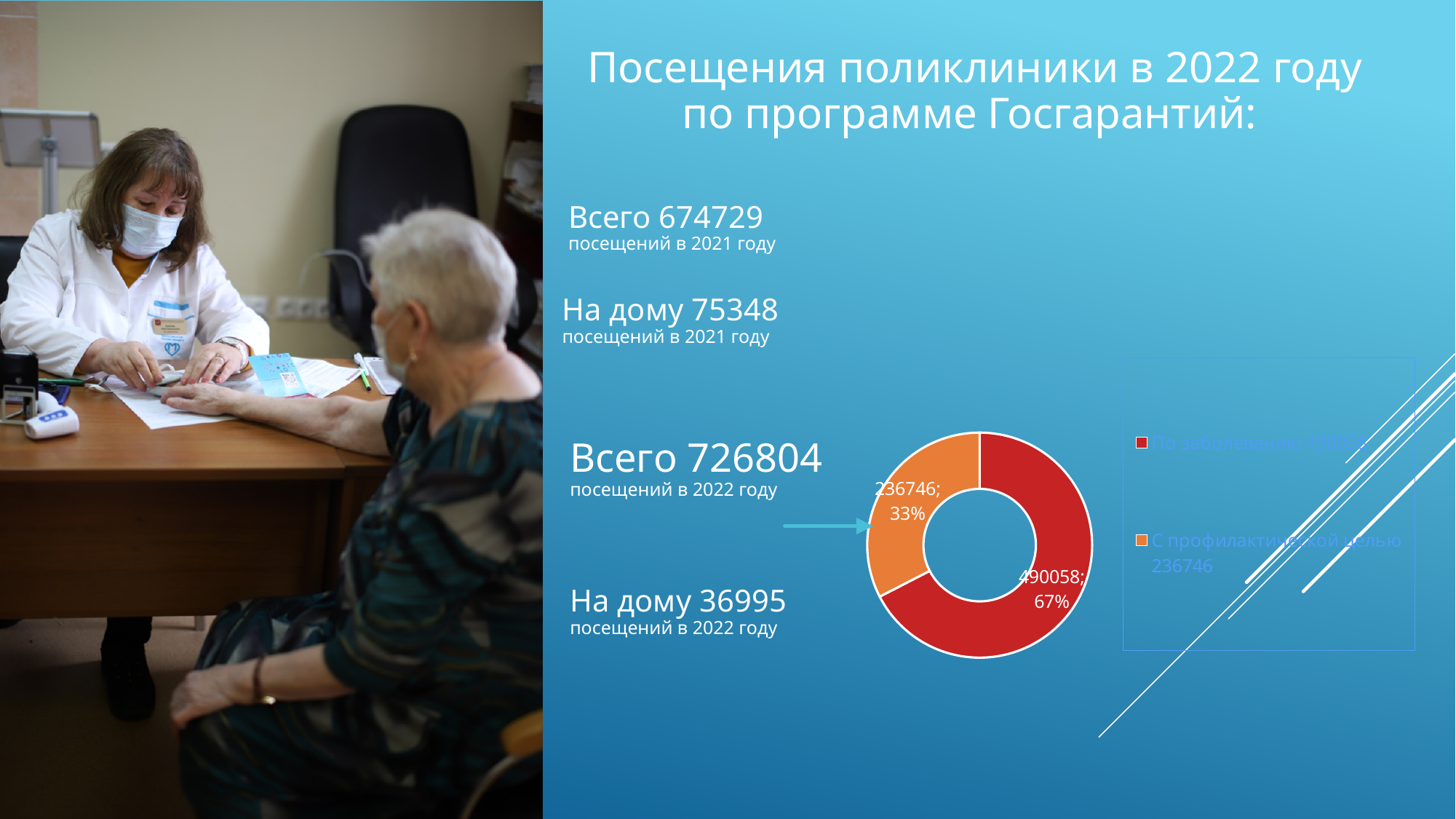
Which category has the smallest slice in the doughnut chart? С профилактической целью What is the value for "С профилактической целью" in the doughnut chart? 236746 How many entries does the chart legend list? 2 How many slices does the doughnut chart have? 2 What kind of chart is shown on the slide? doughnut chart What colour is the "С профилактической целью" slice in the doughnut chart? orange Which category has the largest slice in the doughnut chart? По заболеванию What is the difference between the values for "По заболеванию" and "С профилактической целью"? 253312 What share of the doughnut chart does "С профилактической целью" represent? 33% What share of the doughnut chart does "По заболеванию" represent? 67% Which is larger: the value for "По заболеванию" or for "С профилактической целью"? По заболеванию What is the value for "По заболеванию" in the doughnut chart? 490058